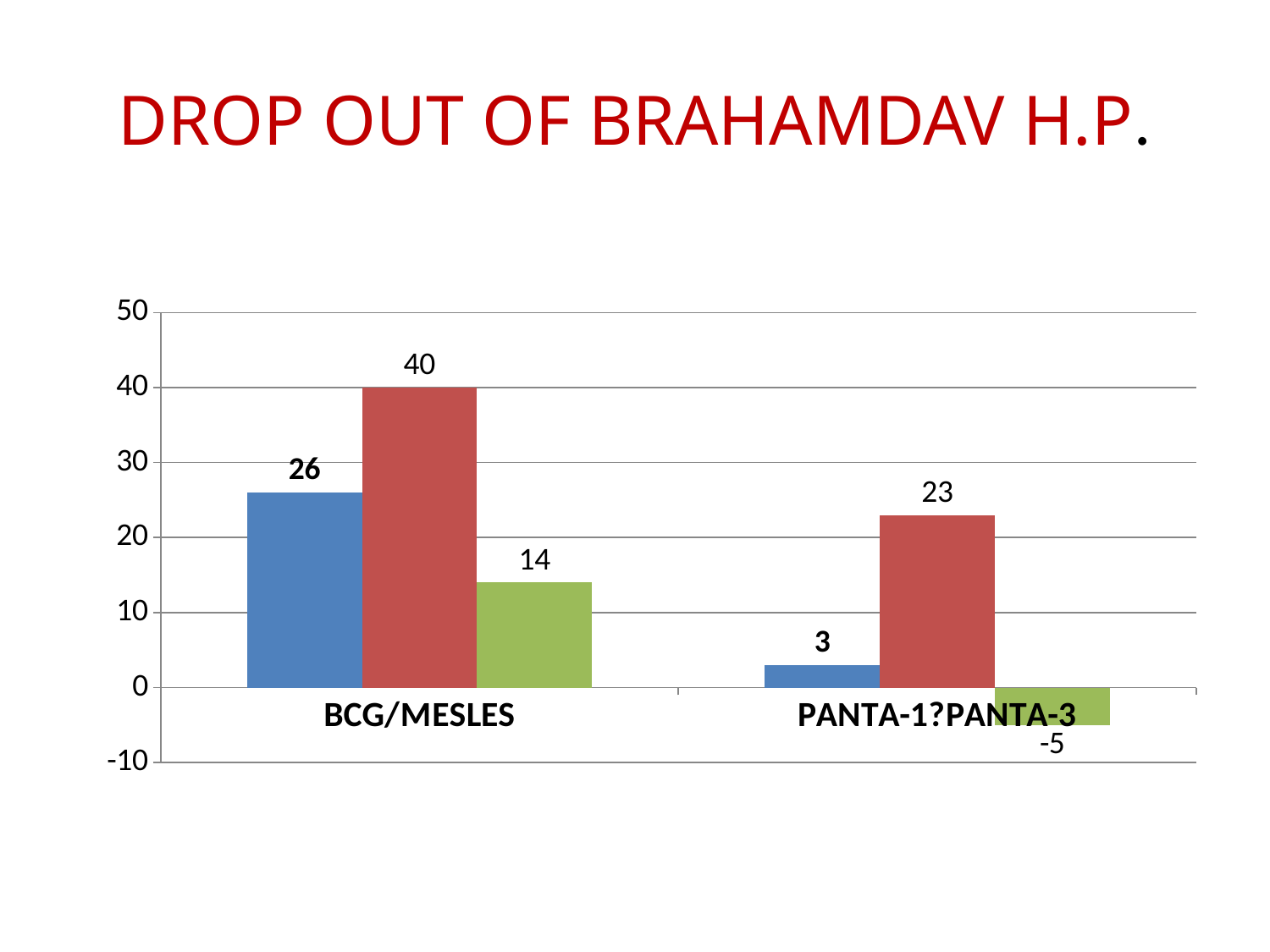
What is the title of the slide? DROP OUT OF BRAHAMDAV H.P. What is the value of the red bar for BCG/MESLES? 40 How many categories are shown on the x axis? 2 What kind of chart is shown on the slide? Bar chart Which bar has the lowest value on the chart? The green bar for PANTA-1?PANTA-3 (-5) What is the value of the blue bar for BCG/MESLES? 26 Which bar has the highest value on the chart? The red bar for BCG/MESLES (40) What is the value of the green bar for PANTA-1?PANTA-3? -5 What is the value of the red bar for PANTA-1?PANTA-3? 23 Which is larger: the green bar for BCG/MESLES or the blue bar for PANTA-1?PANTA-3? The green bar for BCG/MESLES What is the difference between the red bar and the blue bar for BCG/MESLES? 14 What is the difference between the red bar for BCG/MESLES and the red bar for PANTA-1?PANTA-3? 17